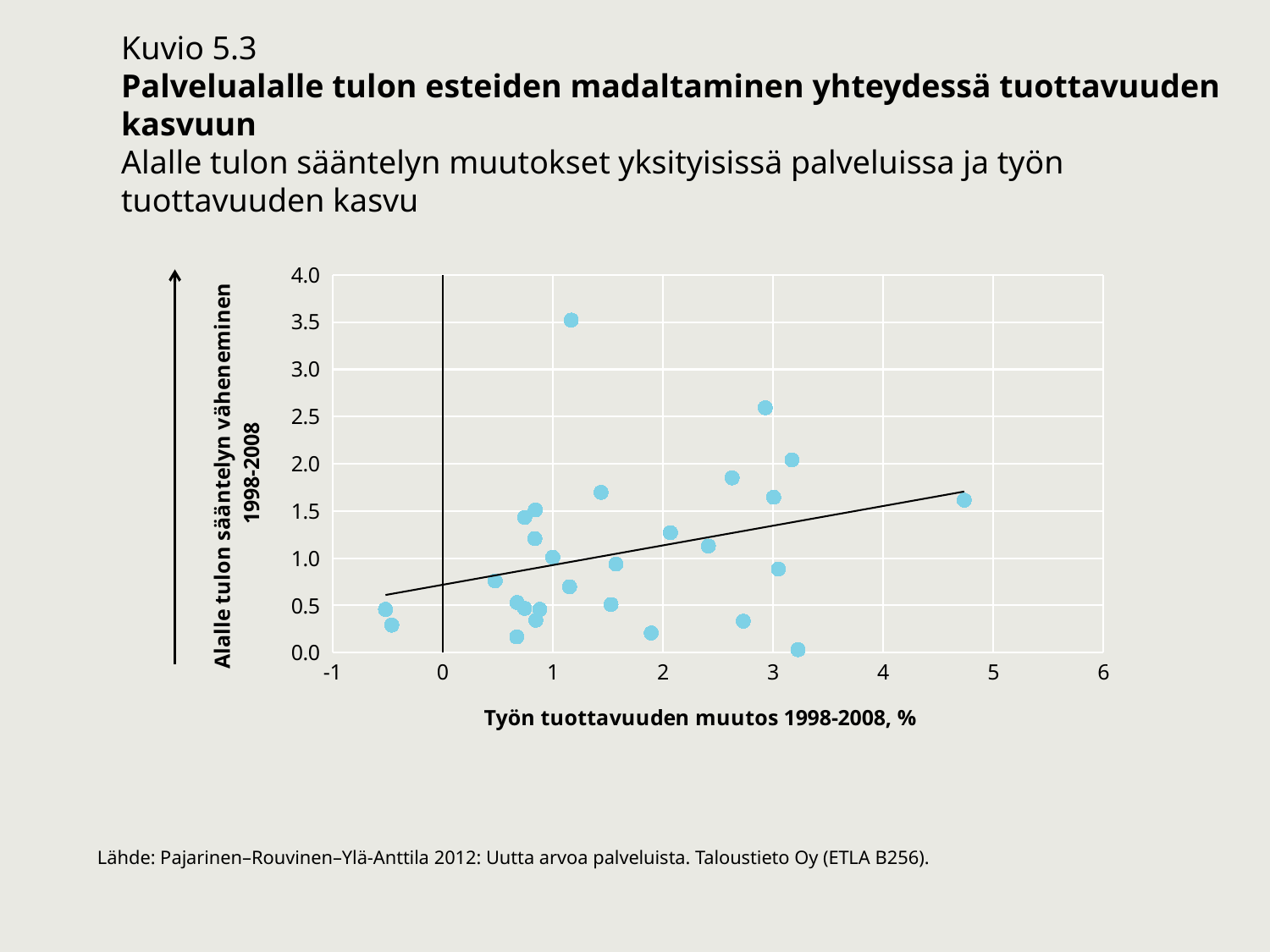
Is the y value of the highest point in the chart greater or less than 3.0? greater Does the fitted trend line in the chart rise or fall as the x-axis value increases? rise Is the y value of the rightmost point in the chart greater or less than 1.5? greater Is the x value of the highest point in the chart greater or less than 2? less What is the title of the x axis of the chart? Työn tuottavuuden muutos 1998-2008, % What kind of chart is shown on the slide? scatter chart What is the title of the y axis of the chart? Alalle tulon sääntelyn väheneminen 1998-2008 How many points in the chart lie to the left of the vertical line at x = 0? 2 How many points in the chart have a y value above 3.0? 1